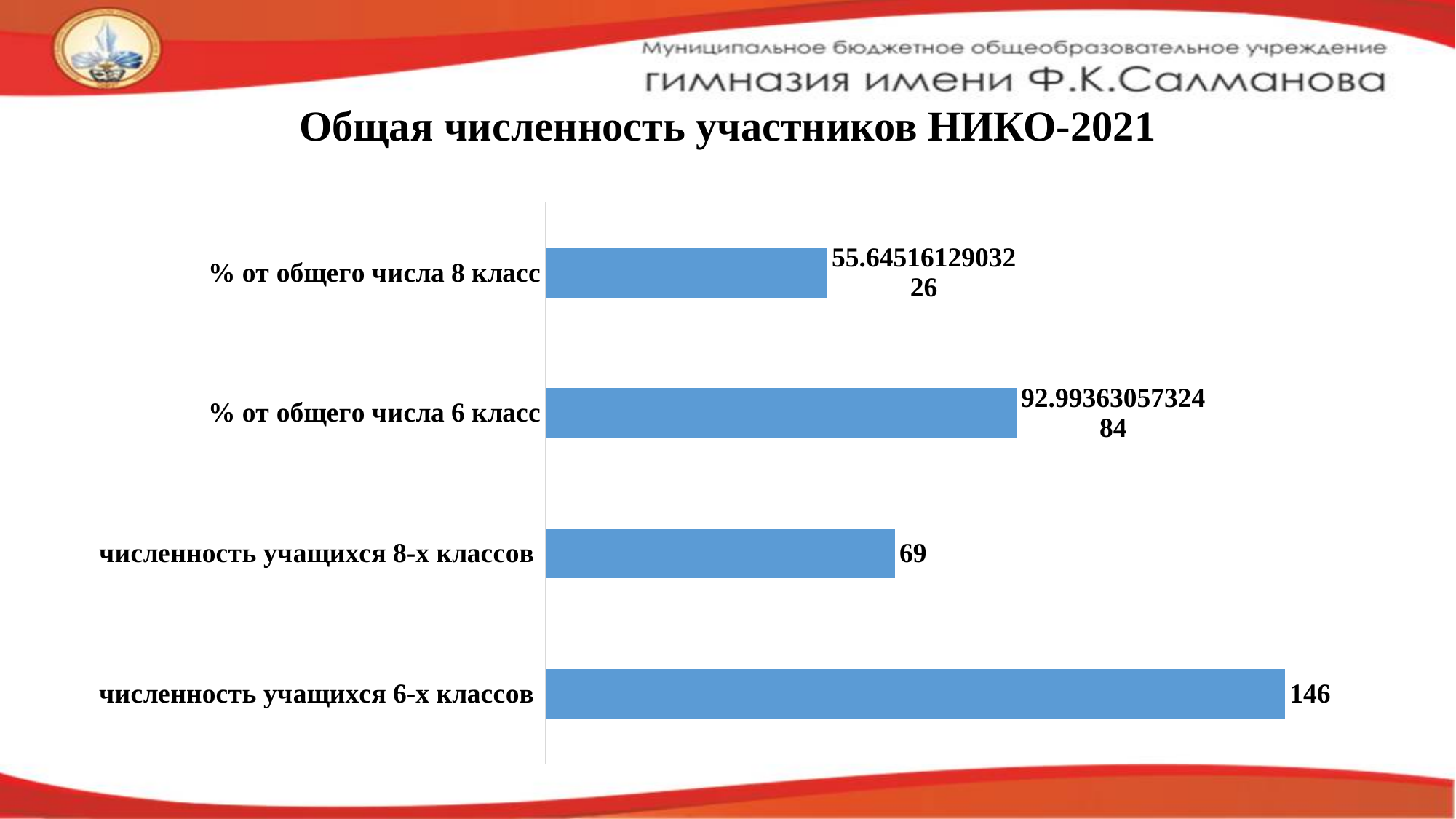
What is the title of the chart? Общая численность участников НИКО-2021 How many categories are shown in the chart? 4 What colour are the bars in the chart? blue Which category has the highest value? численность учащихся 6-х классов What is the value for численность учащихся 8-х классов? 69 What kind of chart is shown on the slide? bar chart What is the value for численность учащихся 6-х классов? 146 What is the value for % от общего числа 6 класс? 92.9936305732484 Which is larger: the value for численность учащихся 8-х классов or the value for % от общего числа 6 класс? % от общего числа 6 класс Which category has the lowest value? % от общего числа 8 класс What is the difference between численность учащихся 6-х классов and численность учащихся 8-х классов? 77 What is the value for % от общего числа 8 класс? 55.6451612903226